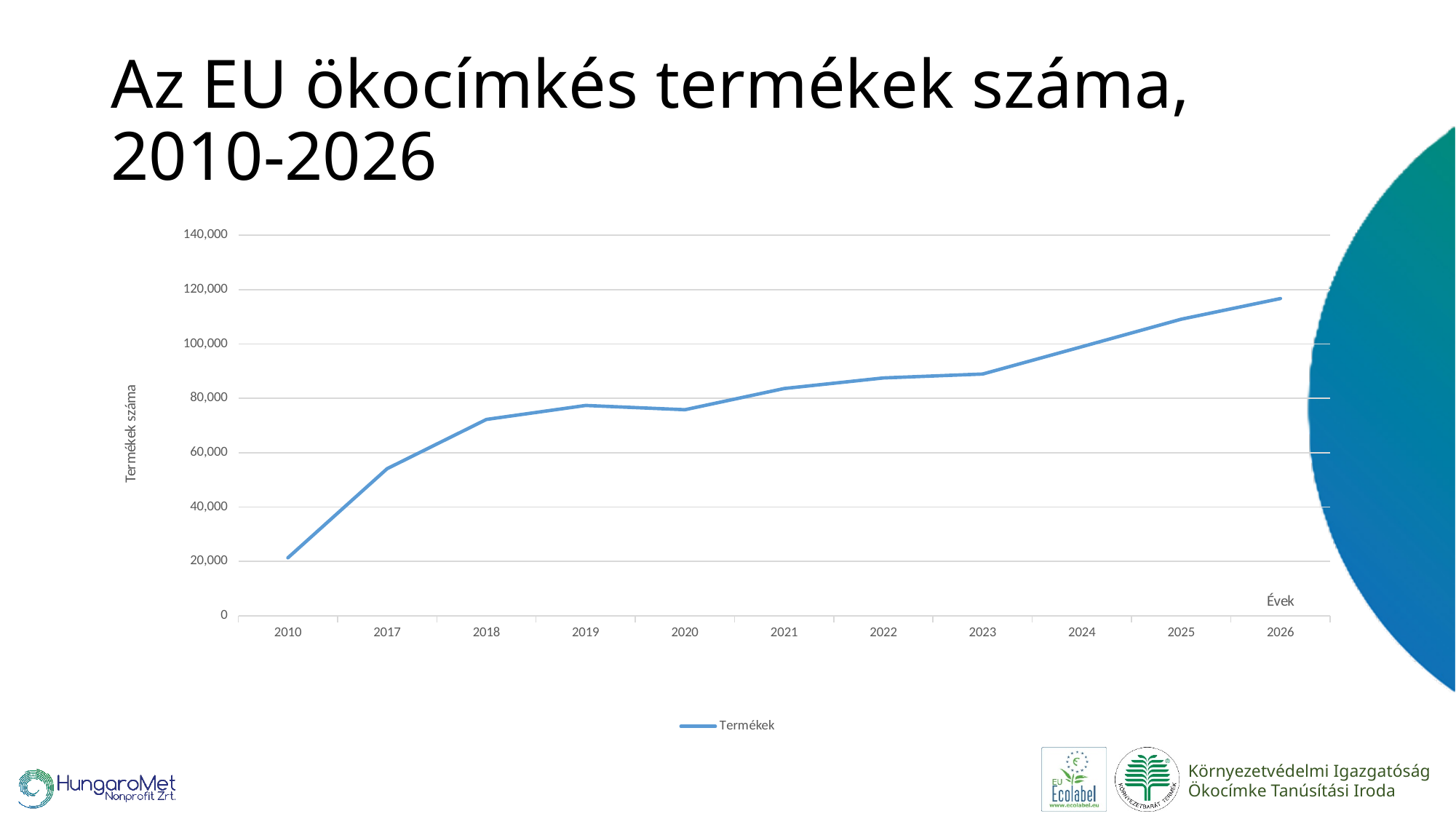
What kind of chart is shown on the slide? line chart Is the value for 2026 greater or less than 120,000? less How many years are plotted on the x axis of the chart? 11 How many series does the chart's legend list? 1 Is the value for 2018 greater or less than 60,000? greater What is the name of the series shown in the chart's legend? Termékek Do the values generally rise or fall from 2010 to 2026? rise Is the value for 2023 greater or less than 80,000? greater Which year has the lowest number of products in the chart? 2010 Which year has the larger value, 2017 or 2018? 2018 Which year has the highest number of products in the chart? 2026